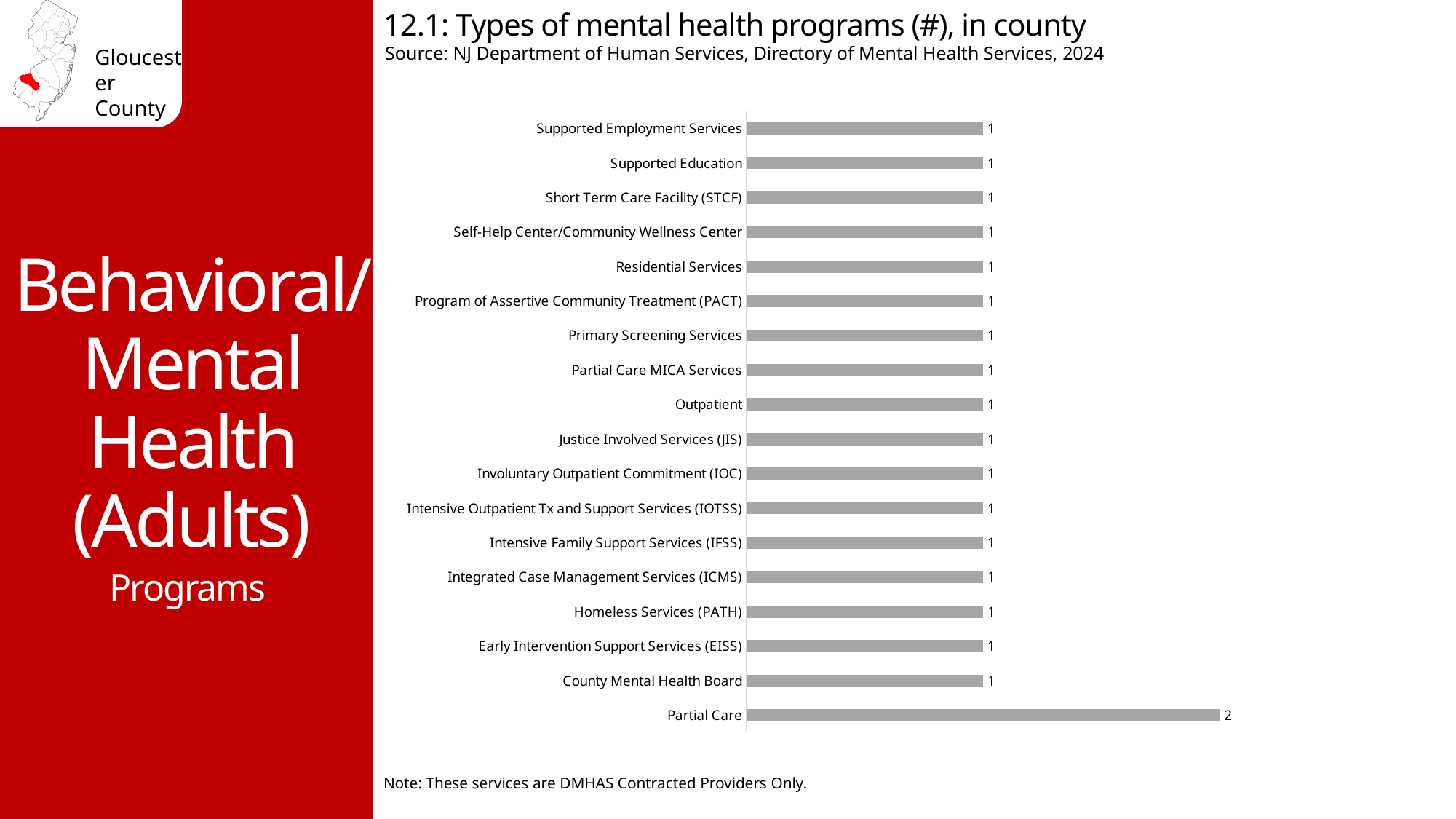
Which program type has the highest value? Partial Care What kind of chart is shown on the slide? Bar chart What is the title of the chart? 12.1: Types of mental health programs (#), in county Which is larger, the value for Partial Care or the value for Residential Services? Partial Care What is the value for Outpatient? 1 What is the difference between the values for Partial Care and Partial Care MICA Services? 1 What is the value for Program of Assertive Community Treatment (PACT)? 1 What is the value for Partial Care? 2 How many program types are shown in the chart? 18 What is the value for County Mental Health Board? 1 What is the value for Homeless Services (PATH)? 1 What is the source cited for the chart? NJ Department of Human Services, Directory of Mental Health Services, 2024